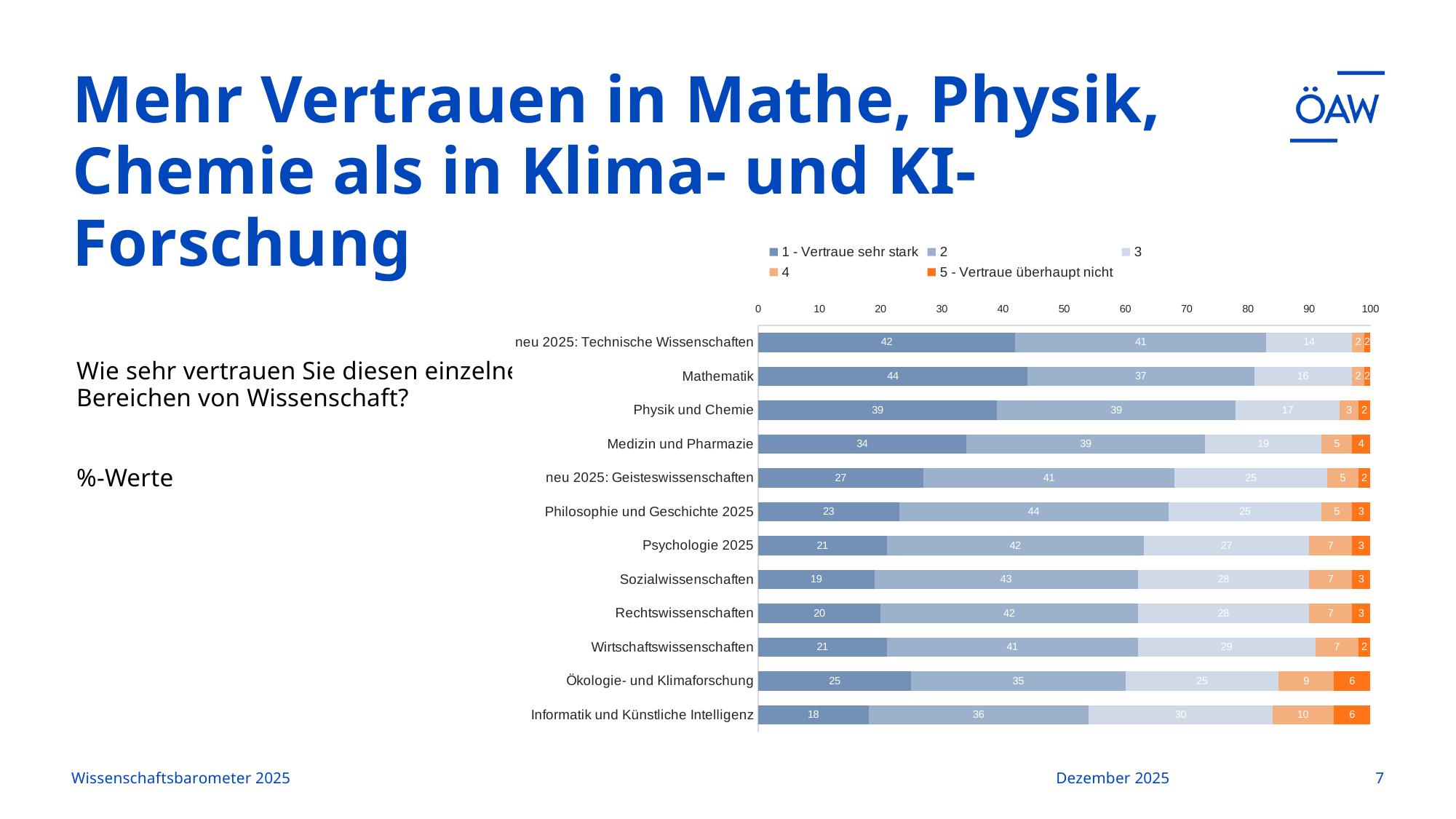
How many series does the legend list? 5 Which category has the lowest value for "1 - Vertraue sehr stark"? Informatik und Künstliche Intelligenz What percentage of respondents chose "1 - Vertraue sehr stark" for Mathematik? 44 What is the difference between the "1 - Vertraue sehr stark" values for Mathematik and Informatik und Künstliche Intelligenz? 26 What is the value of the "3" series for Ökologie- und Klimaforschung? 25 How many categories are shown on the chart? 12 Which category has the highest value for "1 - Vertraue sehr stark"? Mathematik What is the value of the "4" series for Informatik und Künstliche Intelligenz? 10 Which category has the highest value for the "3" series? Informatik und Künstliche Intelligenz What kind of chart is shown on the slide? Stacked bar chart What is the total of the stacked bar for Informatik und Künstliche Intelligenz? 100 Which has a larger "2" value: Philosophie und Geschichte 2025 or Ökologie- und Klimaforschung? Philosophie und Geschichte 2025